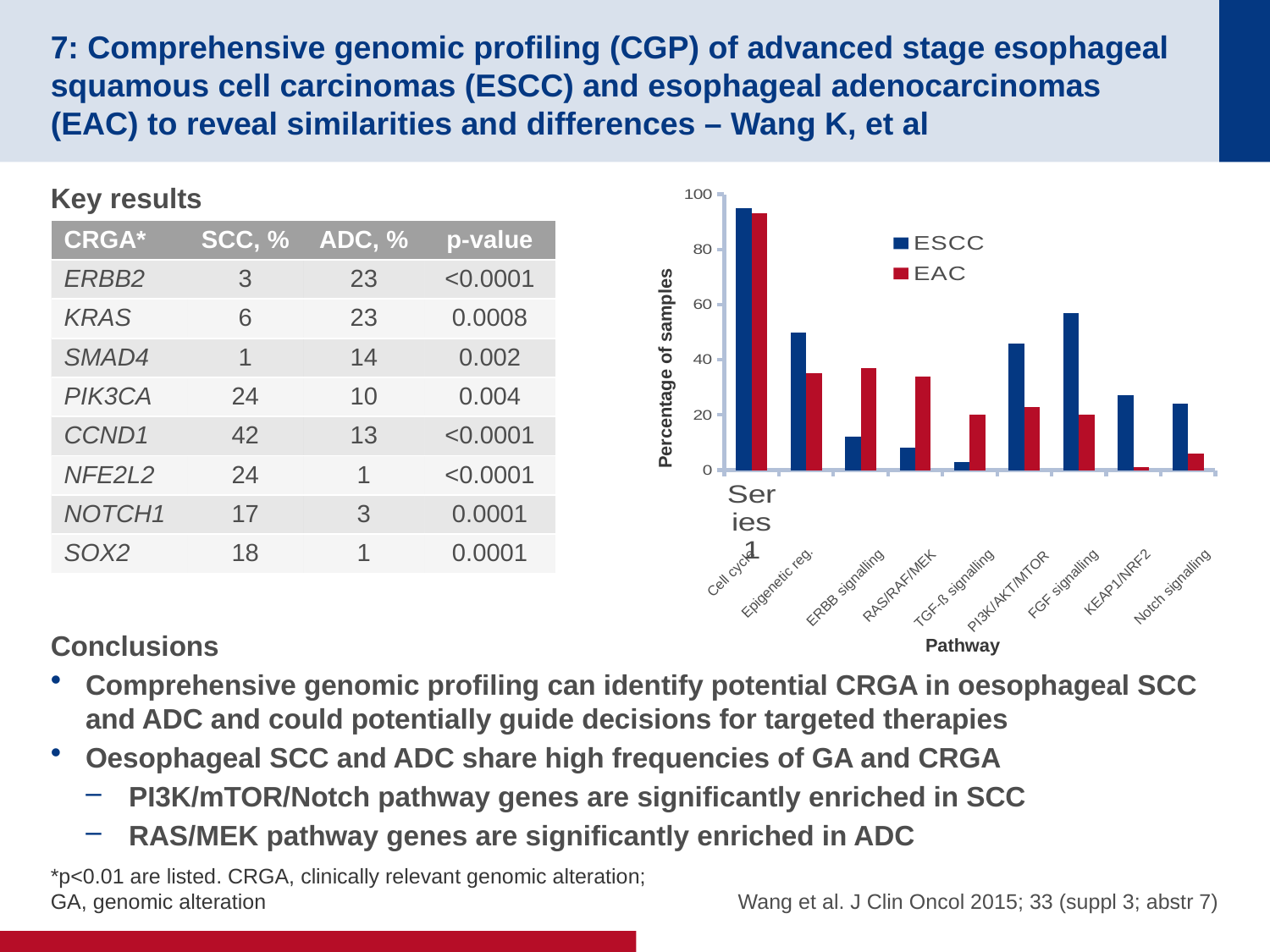
For ERBB signalling, which series has the larger value, ESCC or EAC? EAC Which pathway has the highest ESCC value in the chart? Cell cycle How many pathway categories are plotted on the x axis of the chart? 9 For FGF signalling, which series has the larger value, ESCC or EAC? ESCC Is the ESCC value for Cell cycle greater or less than 80? greater What is the label of the y axis of the chart? Percentage of samples What kind of chart is shown on the slide? bar chart Which pathway has the lowest ESCC value in the chart? TGF-ß signalling Which colour represents the EAC series in the chart? red Is the EAC value for PI3K/AKT/MTOR greater or less than 40? less How many series does the chart legend list? 2 Which pathway has the lowest EAC value in the chart? KEAP1/NRF2